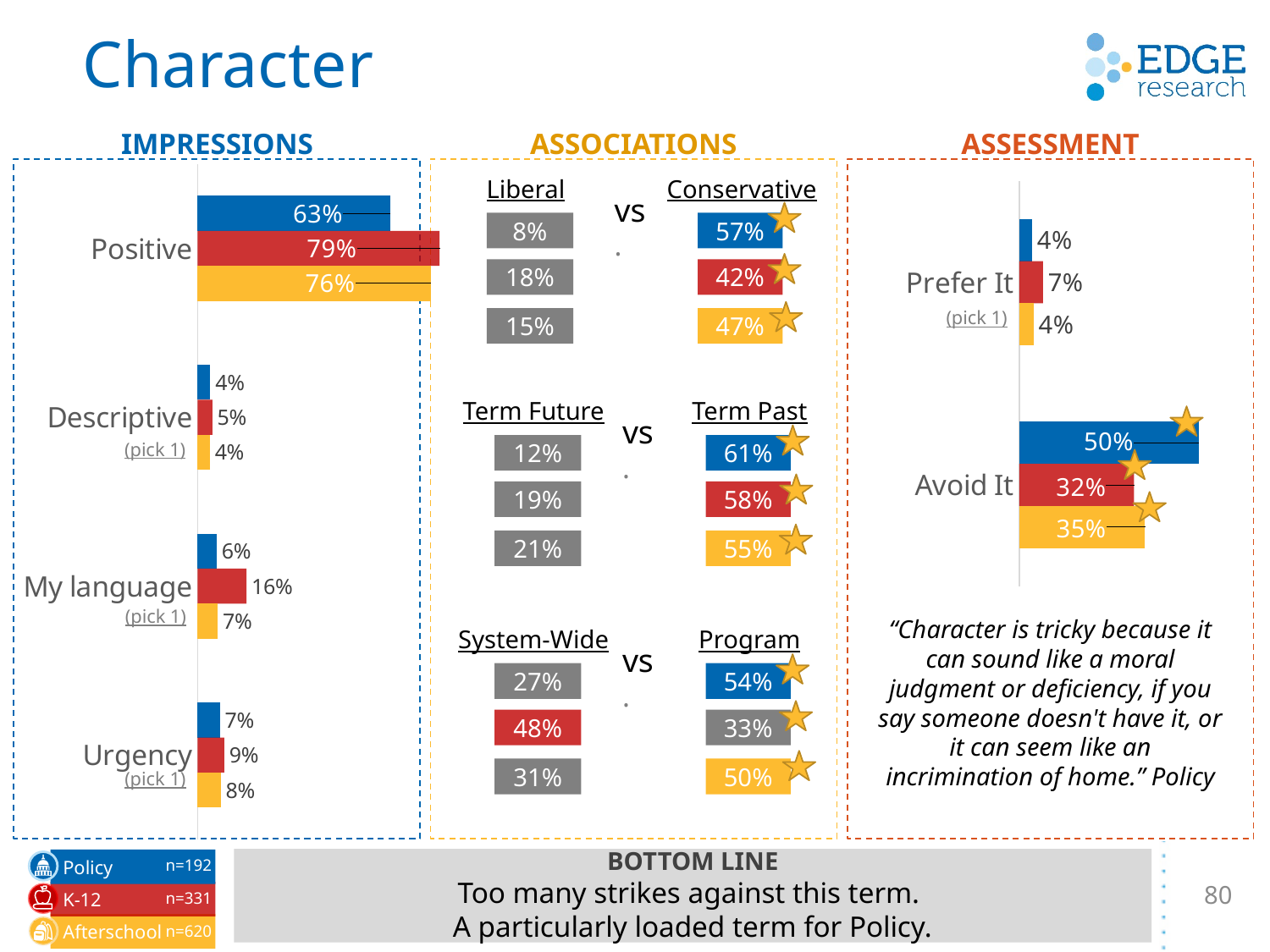
In the ASSESSMENT chart, what is the difference between the Avoid It values for Policy and Afterschool? 15% In the IMPRESSIONS chart, what is the My language value for K-12? 16% In the IMPRESSIONS chart, which group has the highest Positive value? K-12 In the IMPRESSIONS chart, how many categories are shown on the vertical axis? 4 In the IMPRESSIONS chart, what is the difference between the Positive values for K-12 and Policy? 16% In the ASSESSMENT chart, what is the Prefer It value for K-12? 7% In the IMPRESSIONS chart, what is the Positive value for K-12? 79% How many groups does the legend at the bottom of the slide list? 3 In the ASSESSMENT chart, what is the Avoid It value for Policy? 50% In the ASSESSMENT chart, which group has the lowest Avoid It value? K-12 In the ASSESSMENT chart, is the Avoid It value for Policy larger or smaller than the Avoid It value for Afterschool? larger What kind of chart is the IMPRESSIONS chart? bar chart